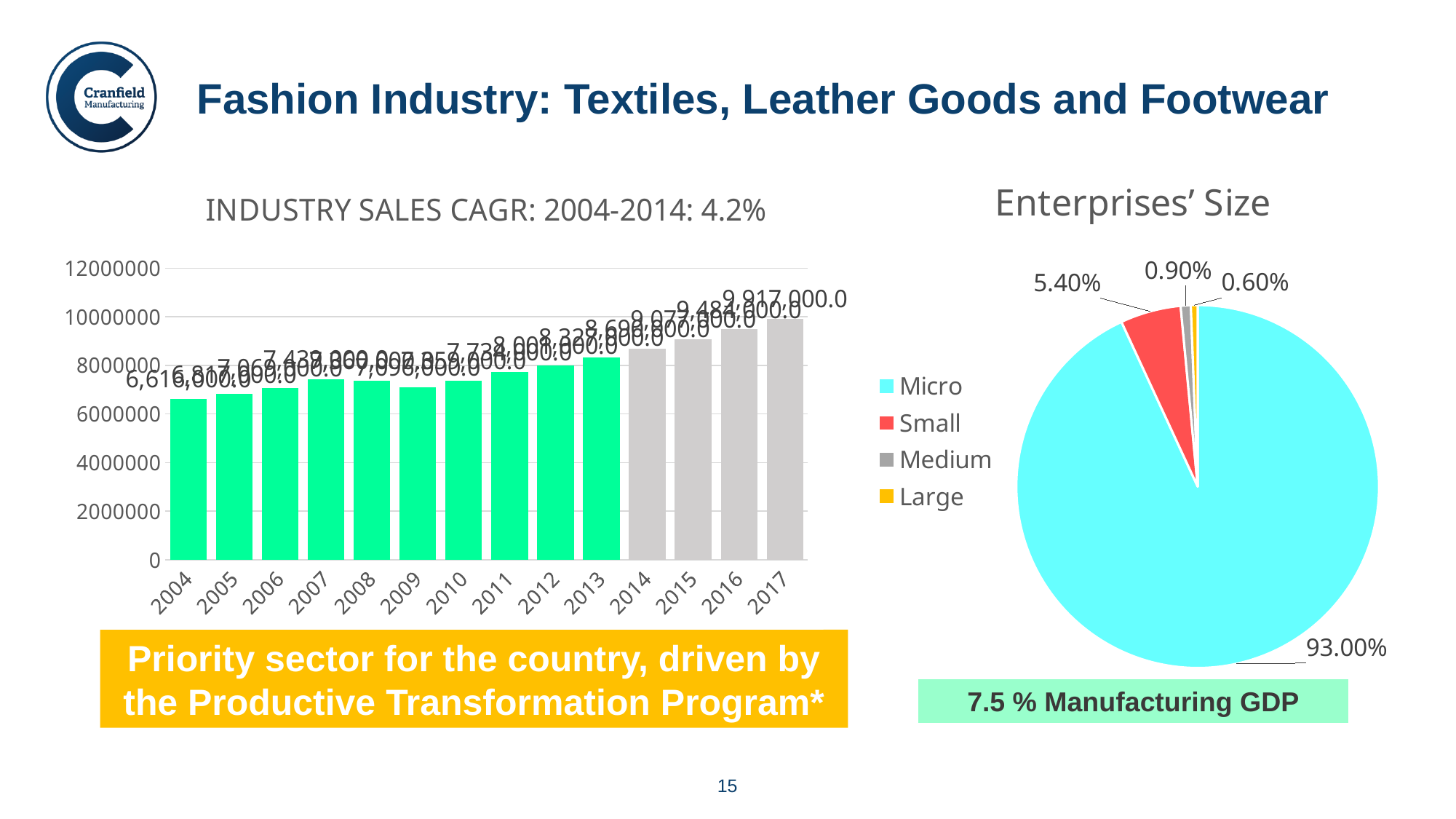
In the 'Enterprises' Size' pie chart, which category has the smallest share? Large In the 'INDUSTRY SALES CAGR' bar chart, which year has the highest value? 2017 In the 'INDUSTRY SALES CAGR' bar chart, what is the value for 2004? 6,616,000.0 In the 'Enterprises' Size' pie chart, what share do Micro enterprises have? 93.00% In the 'INDUSTRY SALES CAGR' bar chart, how many years are shown on the x axis? 14 What kind of chart is the 'INDUSTRY SALES CAGR: 2004-2014: 4.2%' chart? bar chart In the 'INDUSTRY SALES CAGR' bar chart, do the values generally rise or fall from 2004 to 2017? rise What kind of chart is the 'Enterprises' Size' chart? pie chart In the 'INDUSTRY SALES CAGR' bar chart, is the value for 2009 greater or less than 8000000? less In the 'INDUSTRY SALES CAGR' bar chart, is the value for 2014 greater or less than 8000000? greater In the 'INDUSTRY SALES CAGR' bar chart, what is the value for 2017? 9,917,000.0 In the 'Enterprises' Size' pie chart, what is the difference between the Small and Medium shares? 4.50%